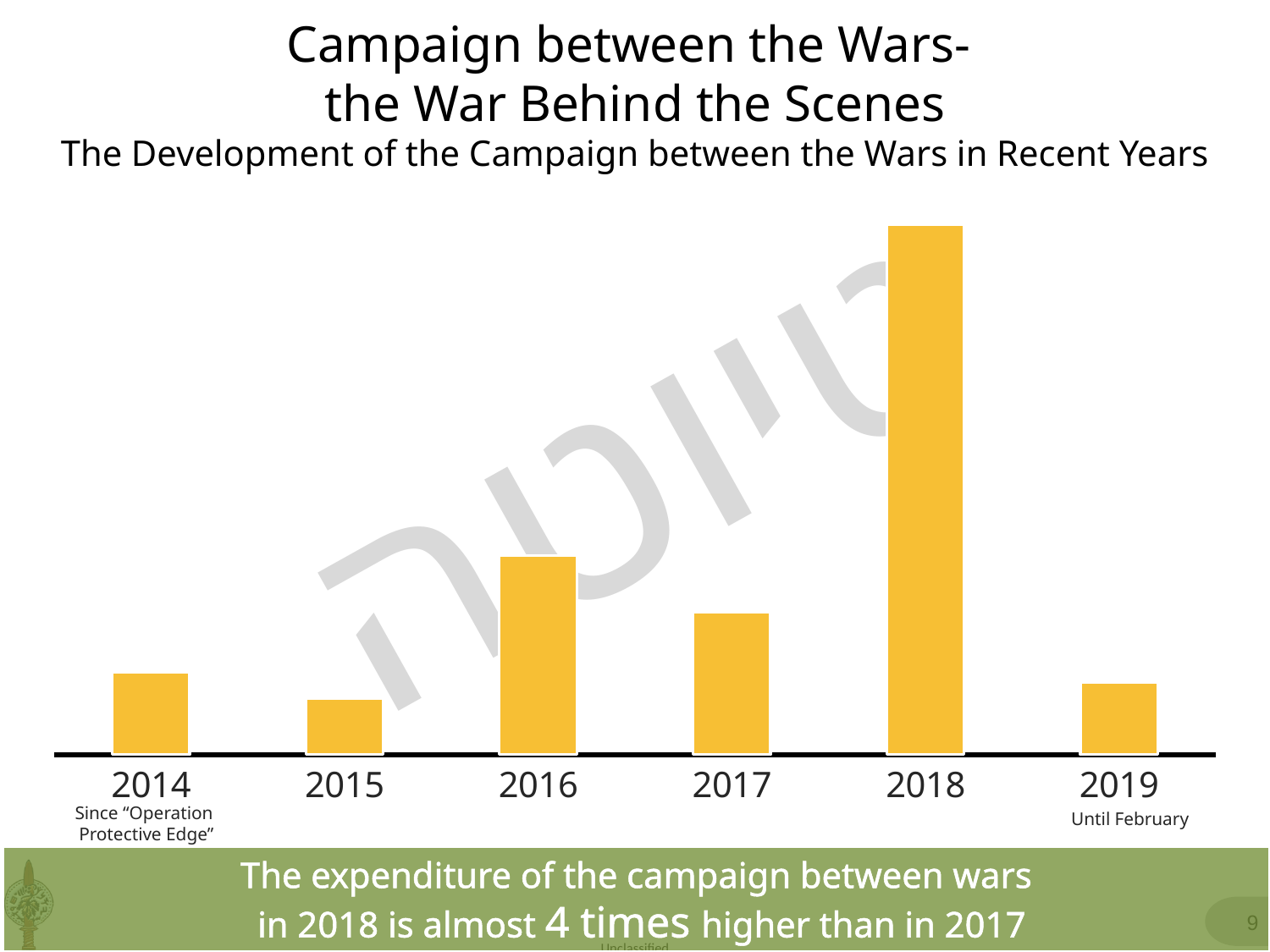
Which year has the tallest bar in the chart? 2018 How many years are shown on the x axis of the chart? 6 Which year has the shortest bar in the chart? 2015 Does the value rise or fall from 2018 to 2019? fall Does the value rise or fall from 2017 to 2018? rise What note appears under the 2019 label on the x axis? Until February Which bar is taller, 2018 or 2016? 2018 Which bar is taller, 2014 or 2017? 2017 What is the subtitle describing the chart on the slide? The Development of the Campaign between the Wars in Recent Years Which bar is taller, 2016 or 2017? 2016 What kind of chart is shown on the slide? bar chart